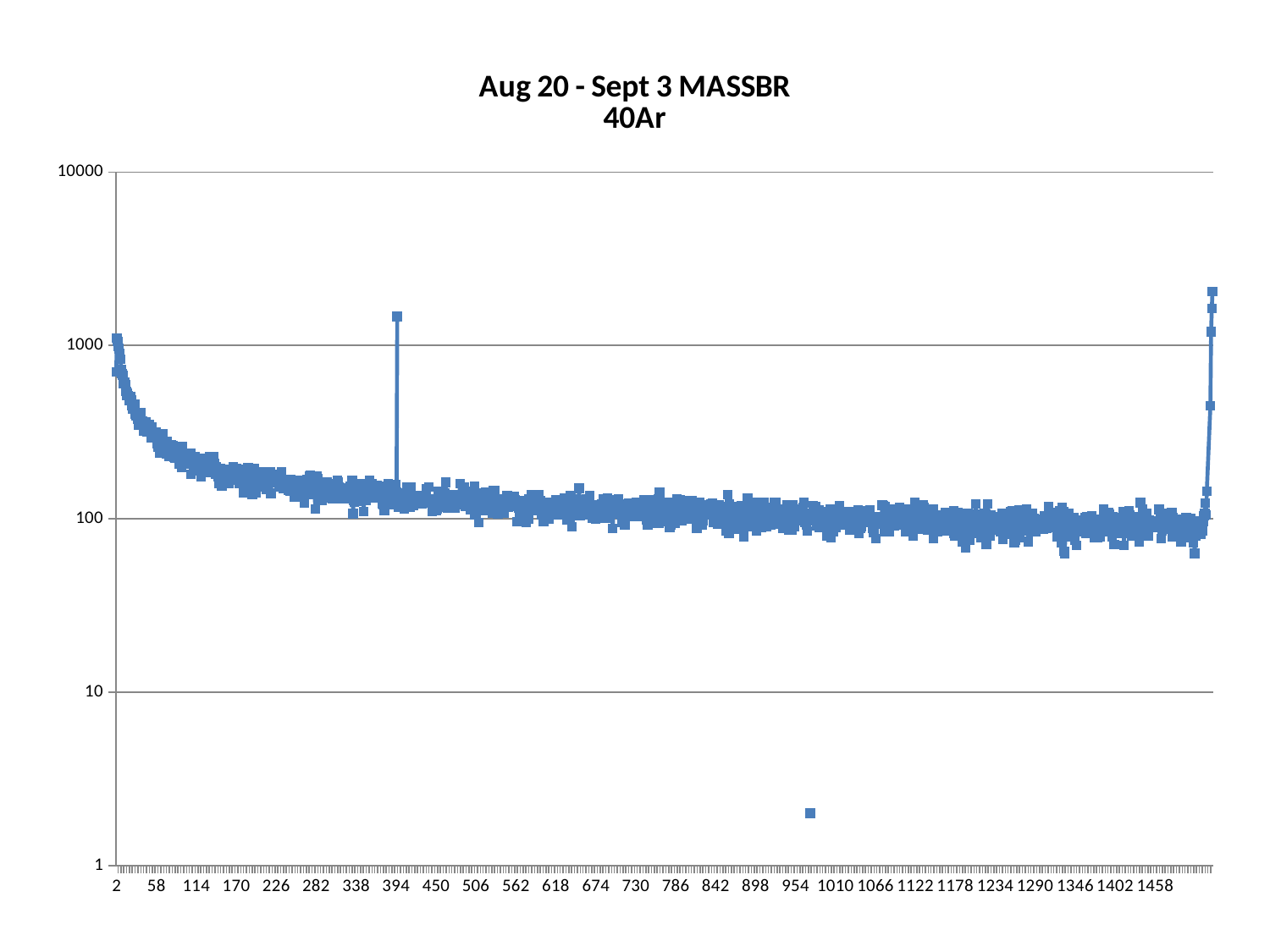
Do the values generally rise or fall between x = 2 and x = 338? fall Is the value at x = 1290 greater or less than 10? greater What is the last label shown on the x axis? 1458 What is the title of the chart? Aug 20 - Sept 3 MASSBR 40Ar Is the value at the spike near x = 394 greater or less than 1000? greater Is the value at x = 730 greater or less than 1000? less What is the first label shown on the x axis? 2 What is the highest value labelled on the y axis? 10000 What kind of chart is shown on the slide? line chart